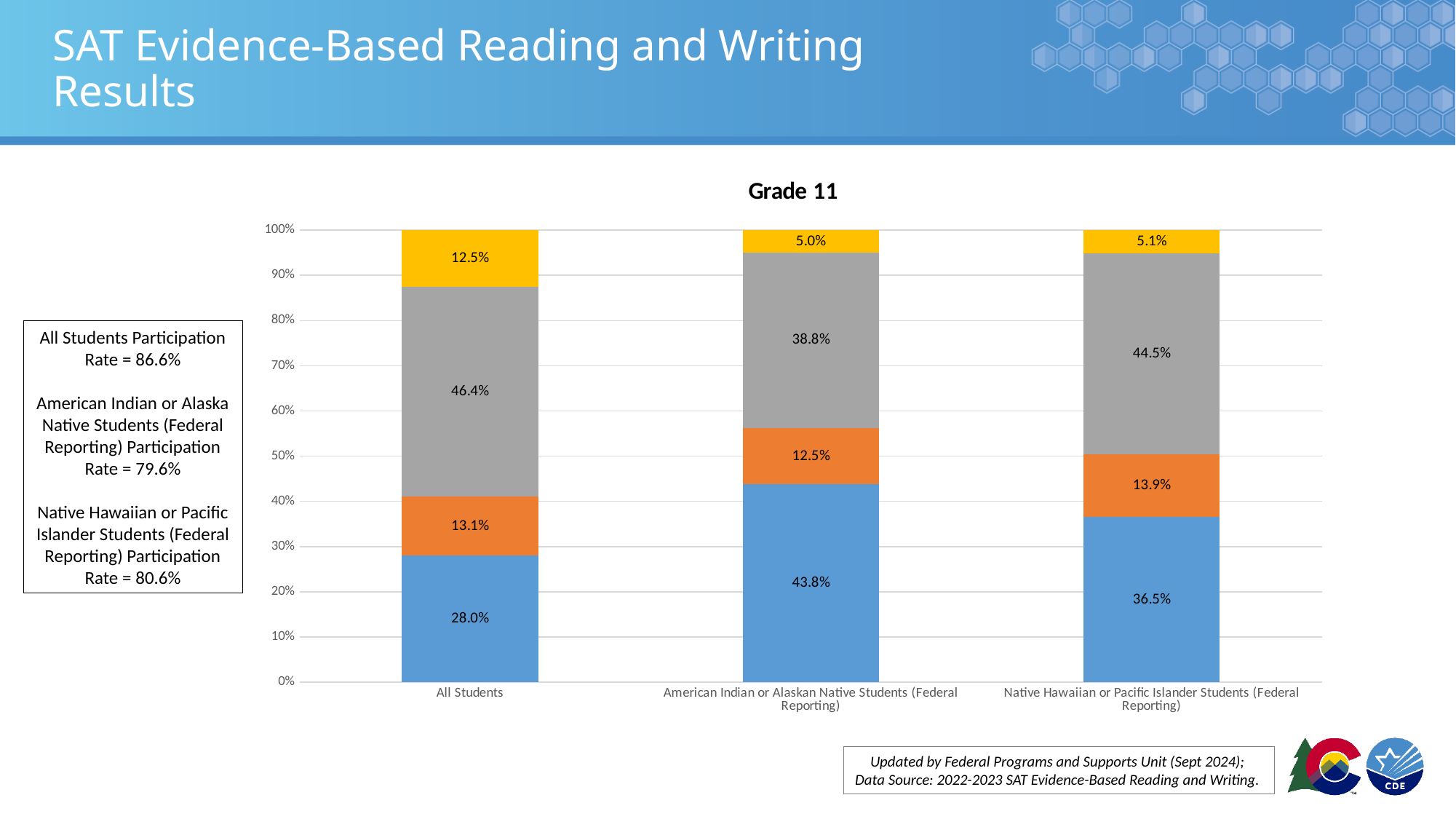
What is the value of the gray segment for Native Hawaiian or Pacific Islander Students (Federal Reporting)? 44.5% Which category has the highest value for the blue (bottom) segment? American Indian or Alaskan Native Students (Federal Reporting) Is the blue (bottom) segment larger for All Students or for Native Hawaiian or Pacific Islander Students (Federal Reporting)? Native Hawaiian or Pacific Islander Students (Federal Reporting) What is the total of the stacked bar for All Students? 100.0% What type of chart is shown on the slide? stacked bar chart What is the value of the blue (bottom) segment for All Students? 28.0% What is the title of the chart? Grade 11 What is the value of the orange segment for Native Hawaiian or Pacific Islander Students (Federal Reporting)? 13.9% What is the difference between the yellow (top) segment for All Students and the yellow segment for Native Hawaiian or Pacific Islander Students (Federal Reporting)? 7.4% Which category has the lowest value for the gray segment? American Indian or Alaskan Native Students (Federal Reporting) What is the value of the yellow (top) segment for American Indian or Alaskan Native Students (Federal Reporting)? 5.0% How many categories are shown on the x axis of the chart? 3